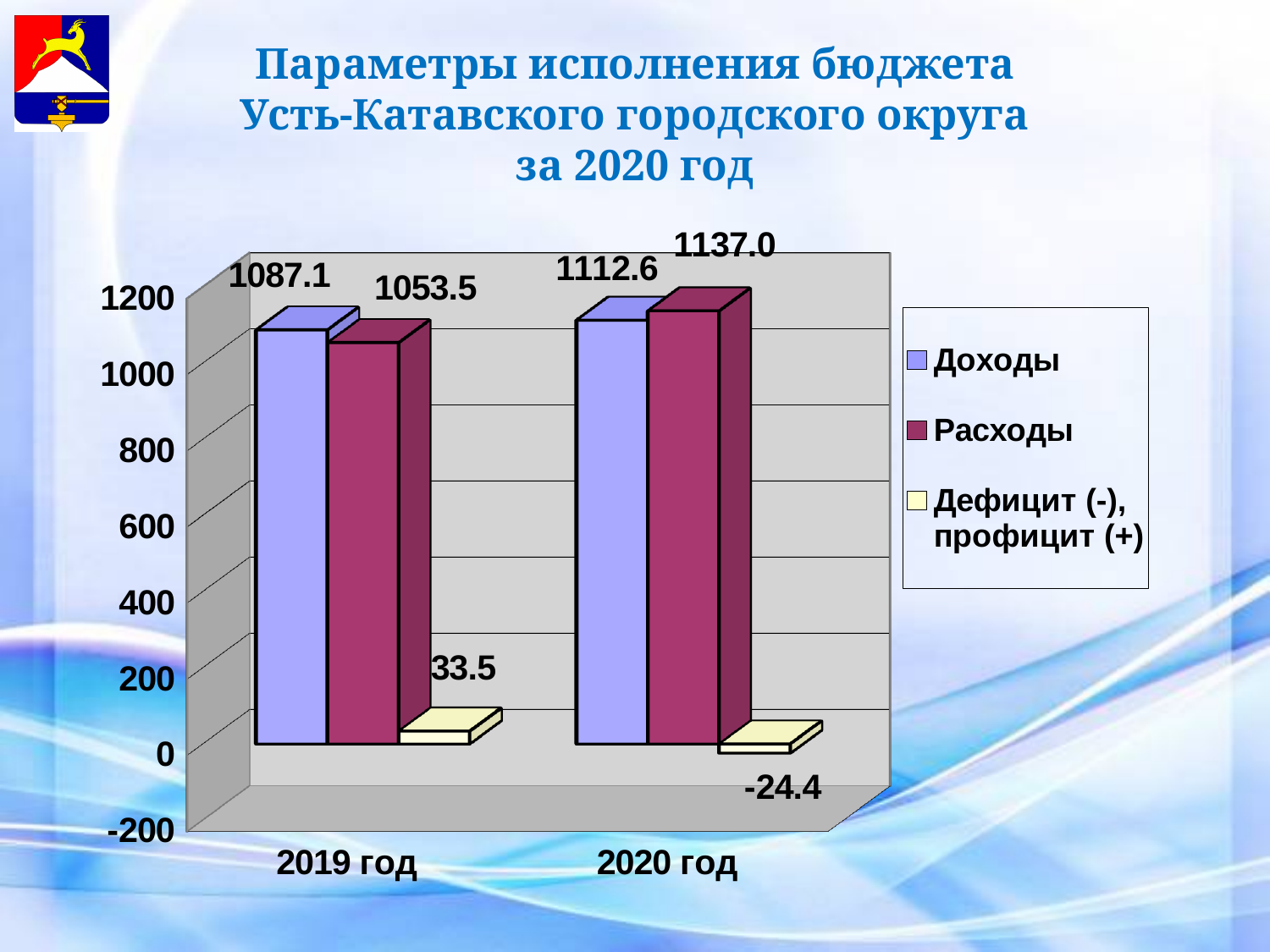
Does the value of Доходы rise or fall from 2019 год to 2020 год? Rise What is the value of Расходы for 2020 год? 1137.0 Which is larger for 2020 год: Доходы or Расходы? Расходы How many categories are shown on the x axis? 2 What is the difference between Доходы for 2020 год and Доходы for 2019 год? 25.5 What is the value of Доходы for 2019 год? 1087.1 What is the value of Дефицит (-), профицит (+) for 2020 год? -24.4 What is the value of Дефицит (-), профицит (+) for 2019 год? 33.5 Which year has the higher value for Расходы? 2020 год How many series does the legend list? 3 What is the difference between Доходы and Расходы for 2019 год? 33.6 What kind of chart is shown on the slide? Bar chart